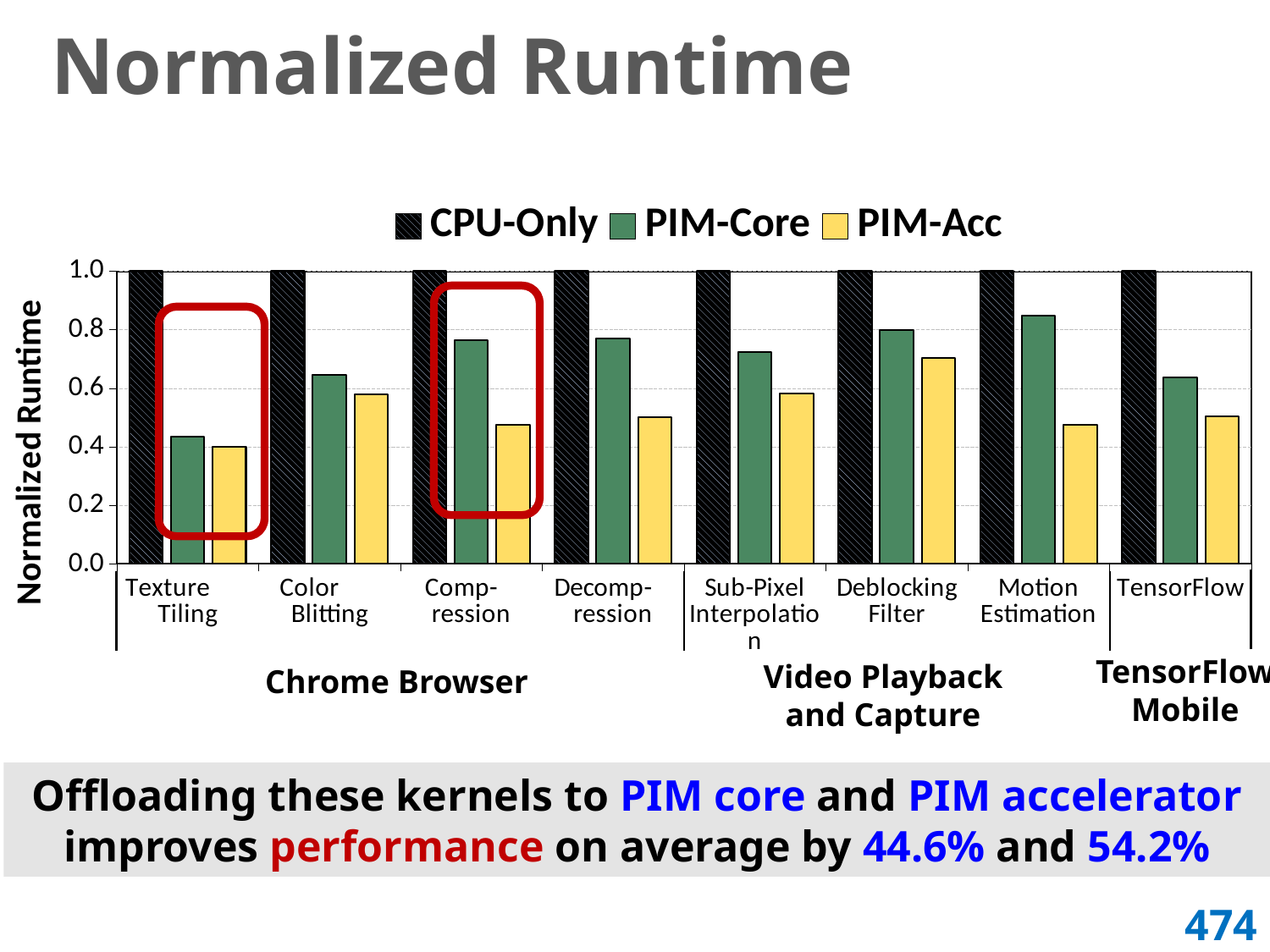
What is the CPU-Only normalized runtime for TensorFlow? 1.0 How many series does the legend list? 3 How many kernel categories are plotted along the x axis? 8 Is the PIM-Core value for Texture Tiling greater or less than 0.6? less Is the PIM-Core value for Compression greater or less than 0.6? greater What is the label on the y axis? Normalized Runtime Which category has the highest PIM-Acc normalized runtime? Deblocking Filter Which category has the lowest PIM-Core normalized runtime? Texture Tiling Is the PIM-Acc value for Deblocking Filter greater or less than 0.6? greater For Compression, which is larger: the PIM-Core value or the PIM-Acc value? PIM-Core What kind of chart is shown on the slide? bar chart What is the CPU-Only normalized runtime for Texture Tiling? 1.0